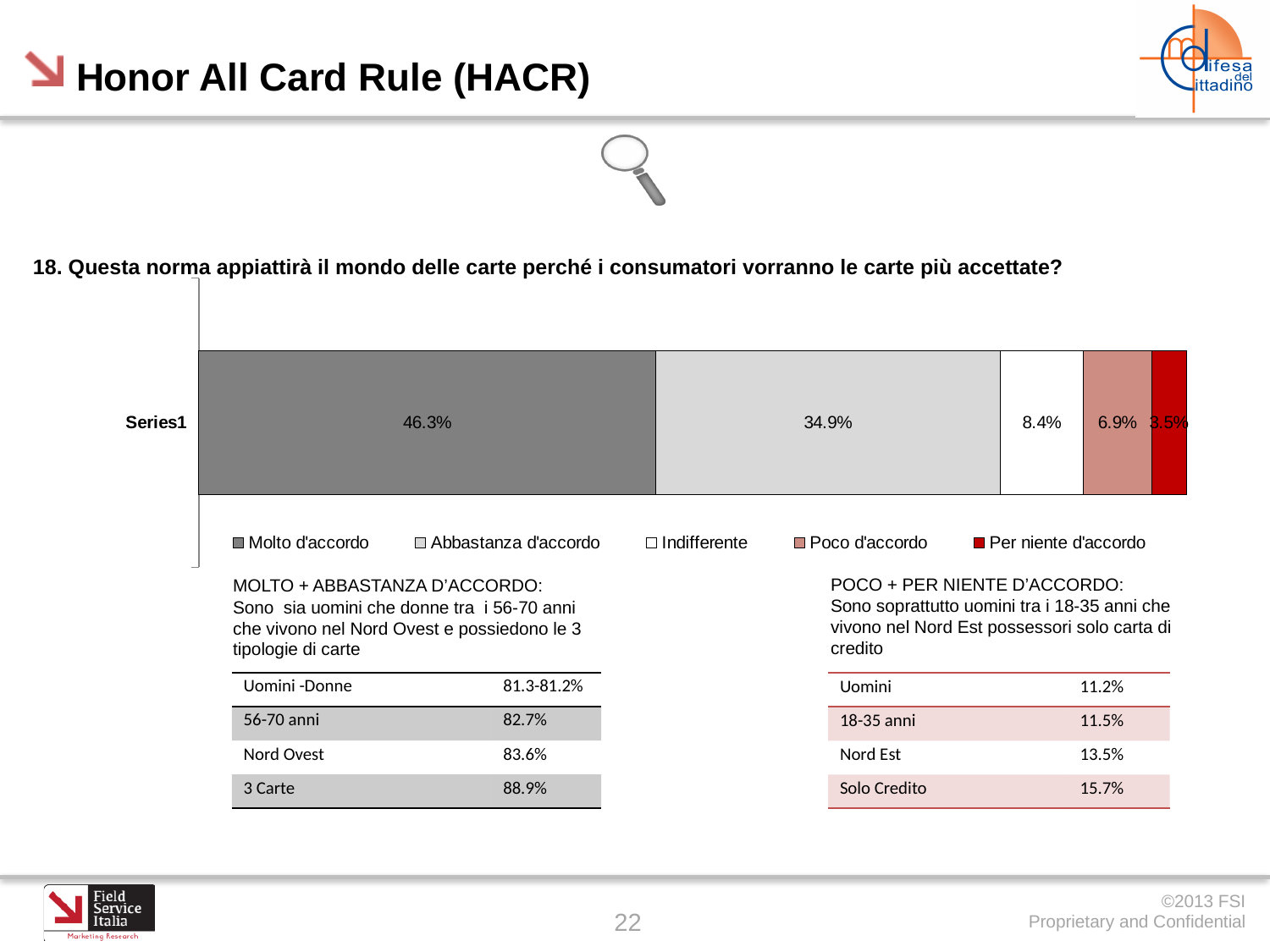
What is the value shown for "Abbastanza d'accordo"? 34.9% What is the value shown for "Indifferente"? 8.4% What colour is the "Per niente d'accordo" segment of the bar? Red What kind of chart is shown on the slide? Stacked bar chart Which response category has the smallest share of the bar? Per niente d'accordo How many series does the chart legend list? 5 Which is larger, the value for "Indifferente" or the value for "Poco d'accordo"? Indifferente Which response category has the largest share of the bar? Molto d'accordo What is the combined total of "Molto d'accordo" and "Abbastanza d'accordo"? 81.2% What is the difference between the "Molto d'accordo" and "Abbastanza d'accordo" values? 11.4% What is the value shown for "Per niente d'accordo"? 3.5% What percentage of respondents answered "Molto d'accordo"? 46.3%